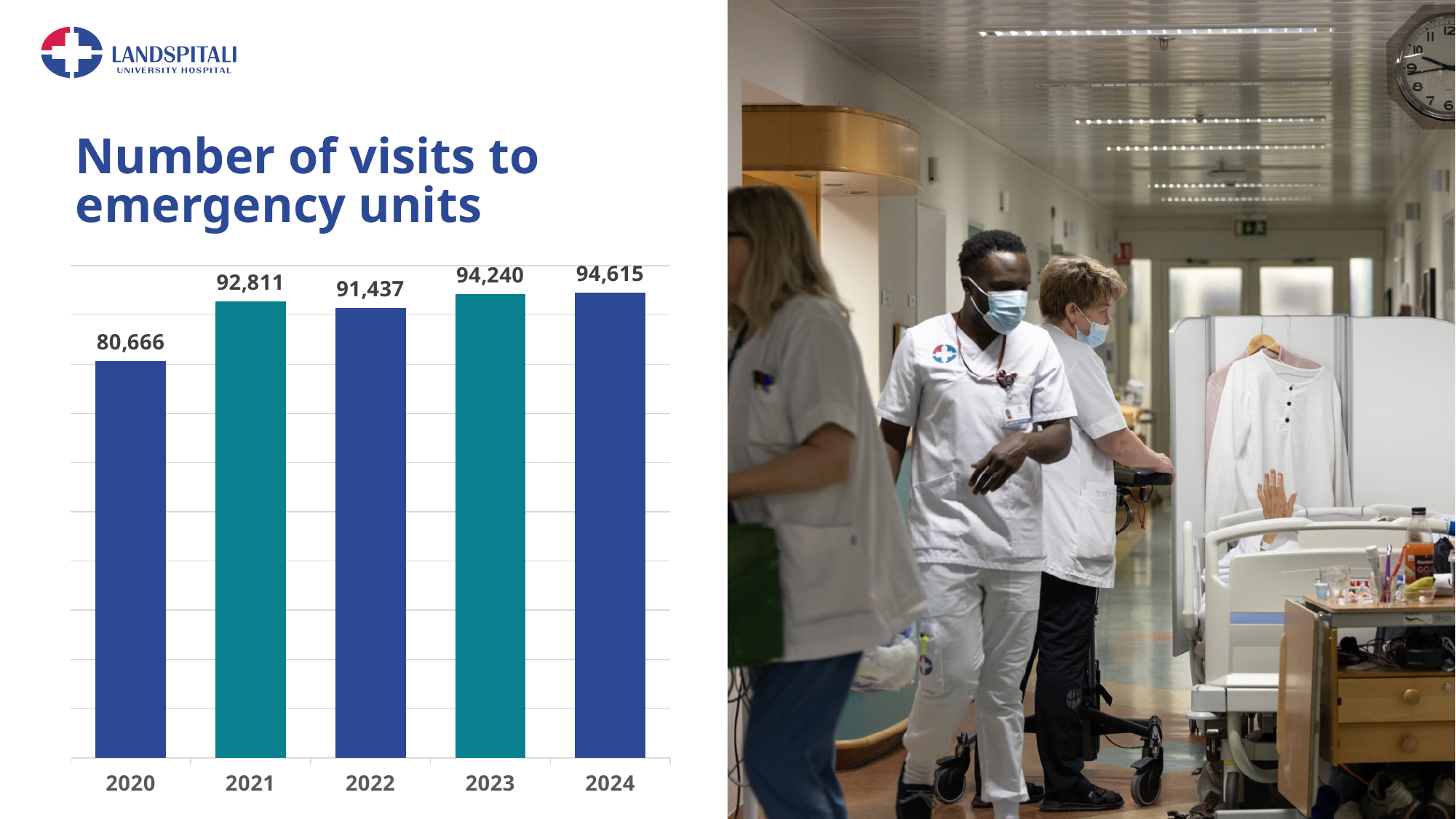
What is the difference in visits between 2023 and 2022? 2,803 What is the title of the chart? Number of visits to emergency units What is the number of visits to emergency units in 2020? 80,666 What is the number of visits to emergency units in 2024? 94,615 How many years are shown on the chart? 5 Did the number of visits rise or fall from 2020 to 2021? Rise What is the difference in visits between 2021 and 2020? 12,145 Which year has the highest number of visits to emergency units? 2024 What kind of chart is shown on the slide? Bar chart Which year has the lowest number of visits to emergency units? 2020 Which year had more visits, 2021 or 2022? 2021 What is the number of visits to emergency units in 2022? 91,437